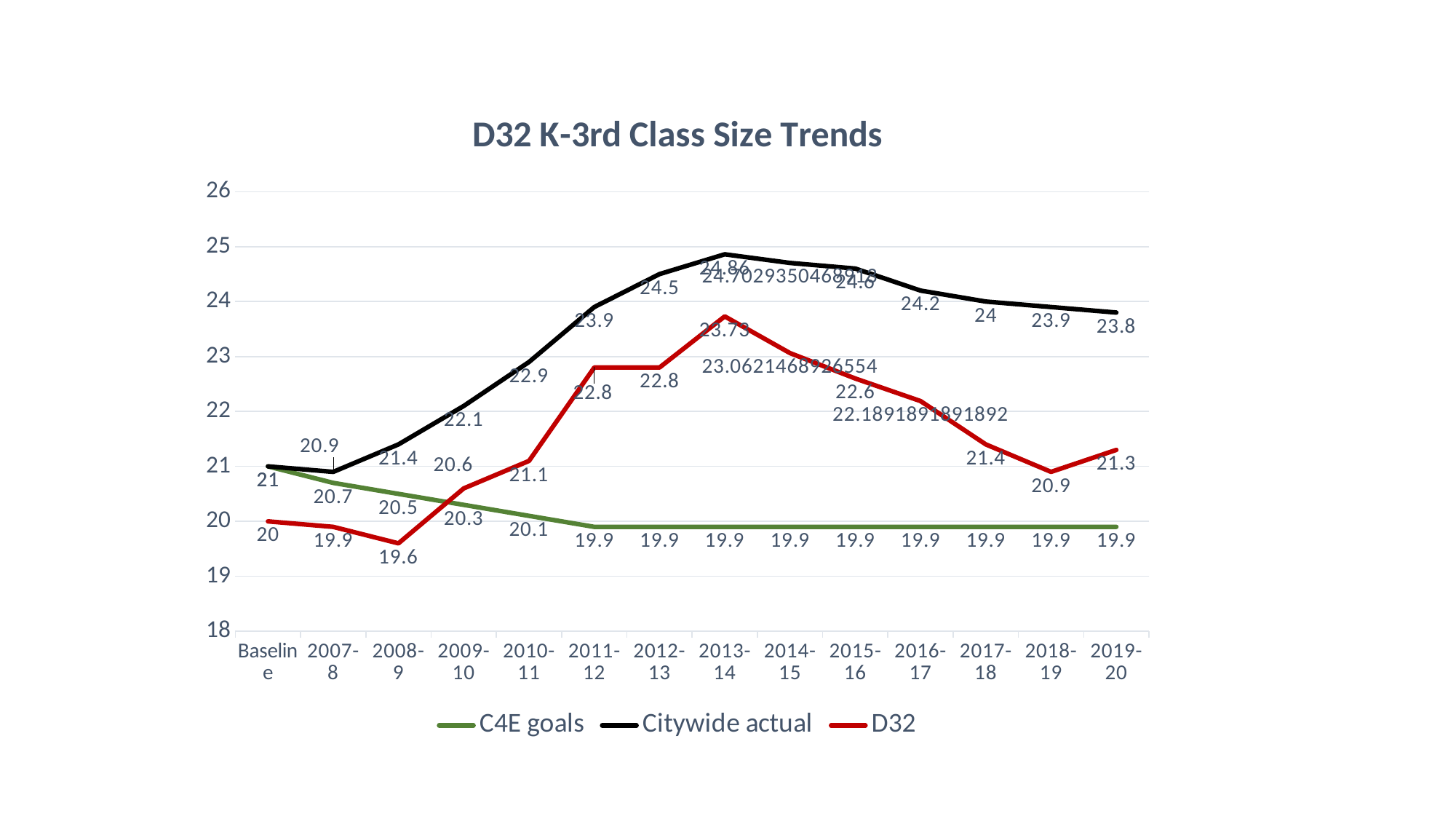
What kind of chart is shown on the slide? line chart In which year does the Citywide actual series reach its highest value? 2013-14 What is the difference between the Citywide actual and D32 values for 2019-20? 2.5 For 2012-13, which is larger: the Citywide actual value or the D32 value? Citywide actual What is the title of the chart? D32 K-3rd Class Size Trends How many series does the legend list? 3 What is the D32 value for 2018-19? 20.9 Do the C4E goals values rise or fall from Baseline to 2011-12? fall What is the Citywide actual value for 2019-20? 23.8 How many categories are shown along the x axis? 14 What is the C4E goals value for 2008-9? 20.5 In which year is the D32 series at its lowest value? 2008-9